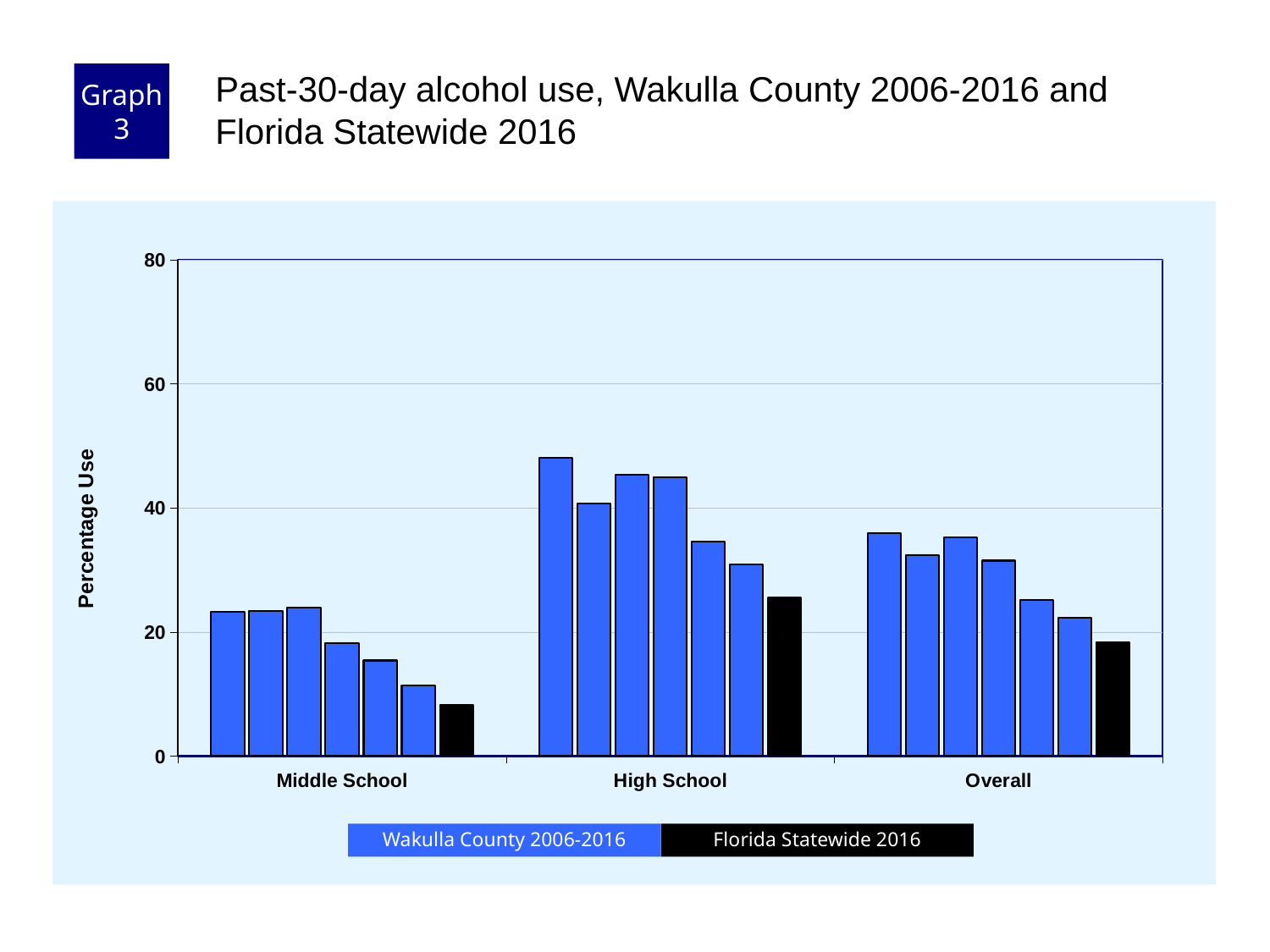
How many categories are shown on the x axis? 3 Which series is shown in black? Florida Statewide 2016 How many series does the legend list? 2 What is the label of the y axis? Percentage Use Which category has the lowest Florida Statewide 2016 bar? Middle School Is the Florida Statewide 2016 value for High School greater or less than 20? greater What kind of chart is shown on the slide? bar chart Is the Florida Statewide 2016 value for Middle School greater or less than 20? less Is the tallest Wakulla County bar for High School greater or less than 40? greater Which is larger, the Florida Statewide 2016 value for High School or for Overall? High School Which category has the highest bars overall? High School